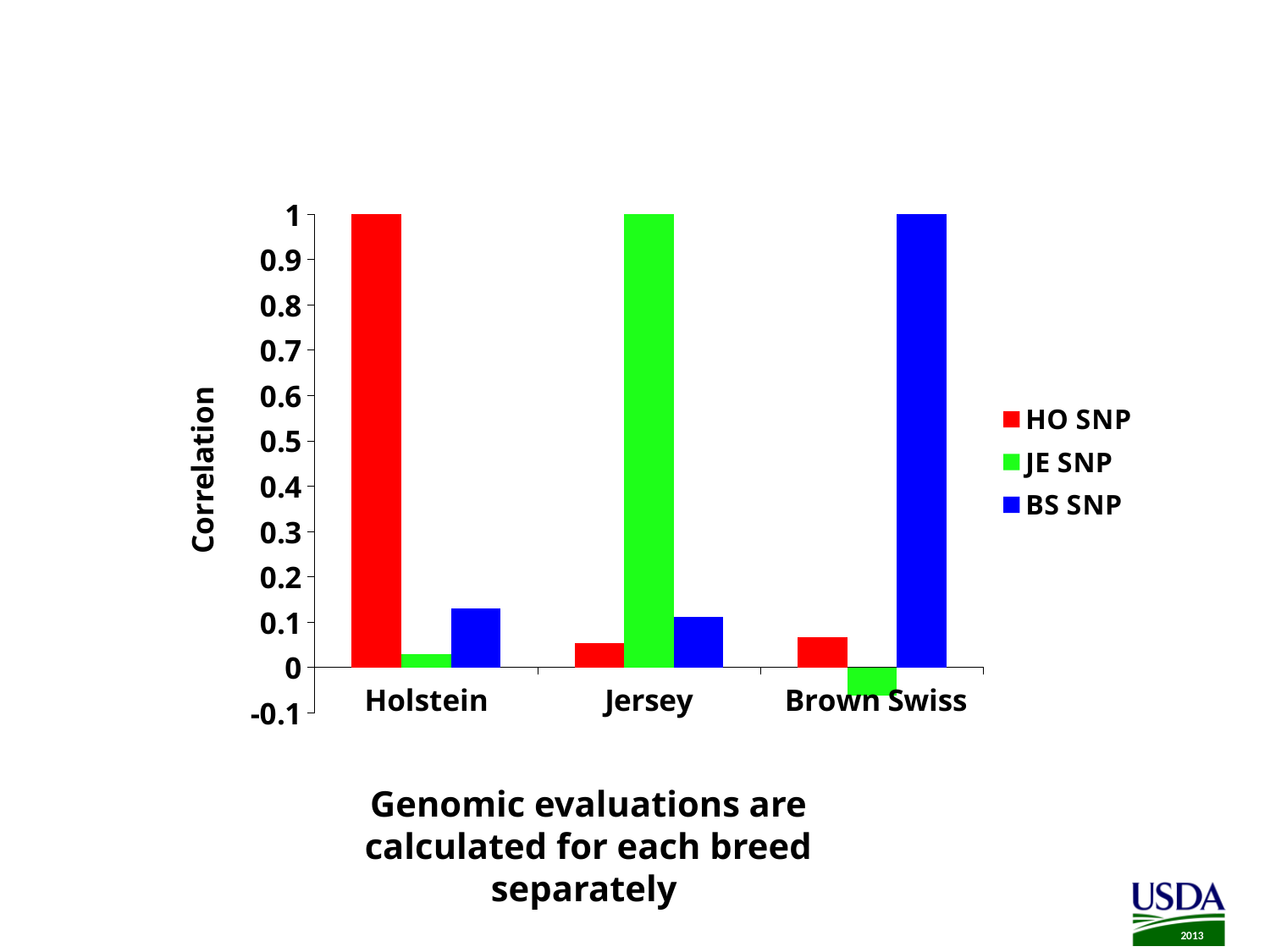
What is the label of the y axis? Correlation Which series has the lowest value for Brown Swiss? JE SNP Which series has the lowest value for Jersey? HO SNP Which series has the highest value for Holstein? HO SNP Is the JE SNP value for Holstein greater or less than 0.1? less What is the BS SNP correlation value for Brown Swiss? 1 How many series does the legend list? 3 Is the JE SNP value for Brown Swiss greater or less than 0? less How many breed categories are shown on the x axis? 3 What kind of chart is shown on the slide? bar chart What is the JE SNP correlation value for Jersey? 1 What is the HO SNP correlation value for Holstein? 1